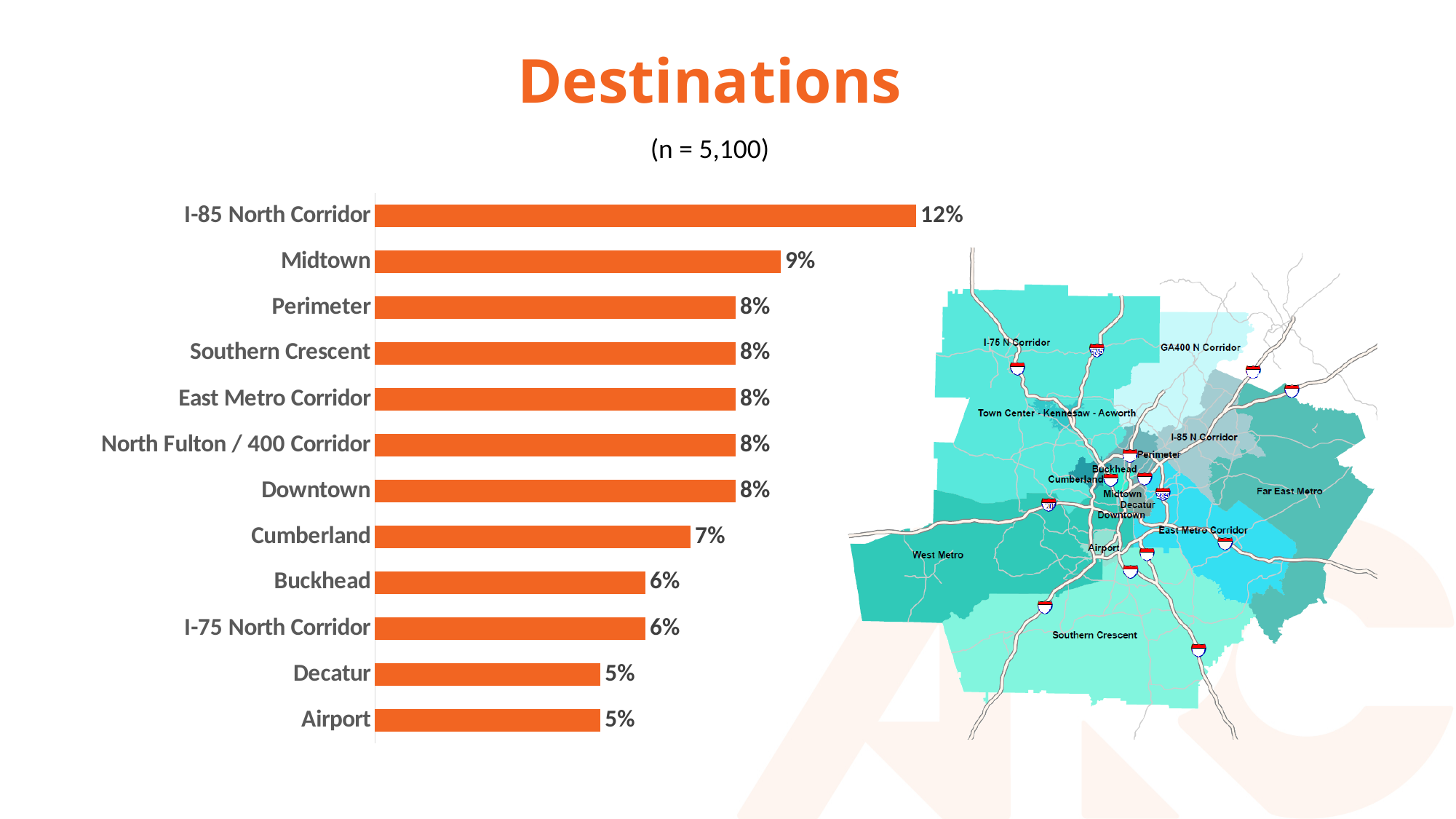
What is the value for I-85 North Corridor? 12% What is the value for Cumberland? 7% Which is larger, the value for Perimeter or the value for Cumberland? Perimeter What is the value for Midtown? 9% Which destination has the highest value? I-85 North Corridor What is the difference between the values for I-85 North Corridor and Midtown? 3% What kind of chart is shown on the slide? Bar chart What is the difference between the values for Cumberland and Decatur? 2% How many destinations are shown in the bar chart? 12 What sample size is shown under the chart title? n = 5,100 What is the value for Airport? 5% Which is larger, the value for Buckhead or the value for Midtown? Midtown